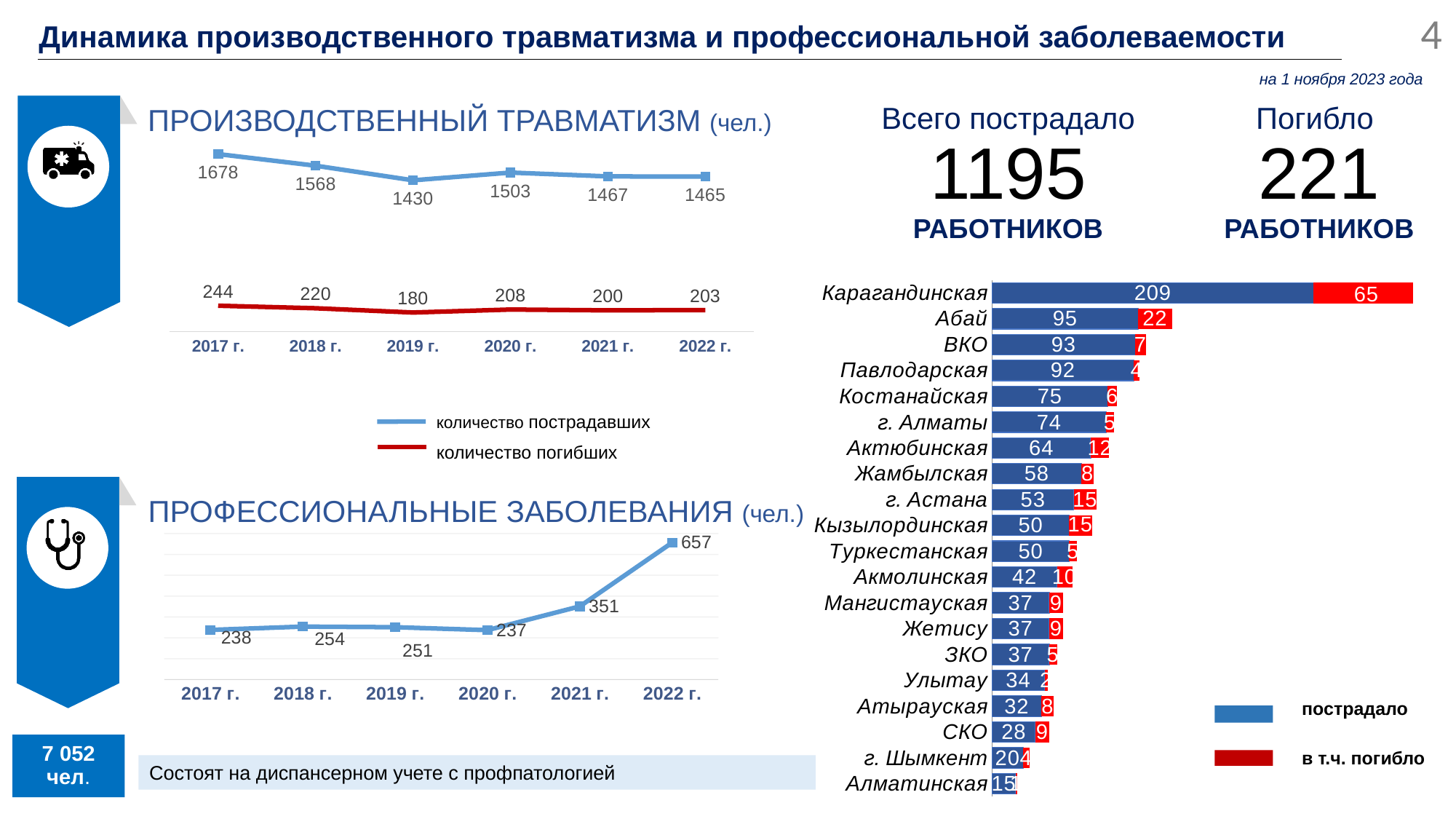
In the regional bar chart on the right, what is the в т.ч. погибло value for Карагандинская? 65 In the ПРОИЗВОДСТВЕННЫЙ ТРАВМАТИЗМ chart, does the количество пострадавших line rise or fall from 2017 г. to 2019 г.? fall In the ПРОИЗВОДСТВЕННЫЙ ТРАВМАТИЗМ chart, what is the количество пострадавших value for 2019 г.? 1430 In the ПРОФЕССИОНАЛЬНЫЕ ЗАБОЛЕВАНИЯ chart, what is the difference between the values for 2022 г. and 2021 г.? 306 In the ПРОФЕССИОНАЛЬНЫЕ ЗАБОЛЕВАНИЯ chart, which year has the highest value? 2022 г. In the ПРОИЗВОДСТВЕННЫЙ ТРАВМАТИЗМ chart, what is the количество погибших value for 2017 г.? 244 In the ПРОИЗВОДСТВЕННЫЙ ТРАВМАТИЗМ chart, what is the difference between количество пострадавших in 2017 г. and 2022 г.? 213 What kind of chart is the regional chart on the right side of the slide? bar chart In the regional bar chart on the right, what is the пострадало value for Абай? 95 In the regional bar chart on the right, which region has the highest пострадало value? Карагандинская In the regional bar chart on the right, how many regions are listed? 20 In the ПРОИЗВОДСТВЕННЫЙ ТРАВМАТИЗМ chart, how many series does the legend list? 2